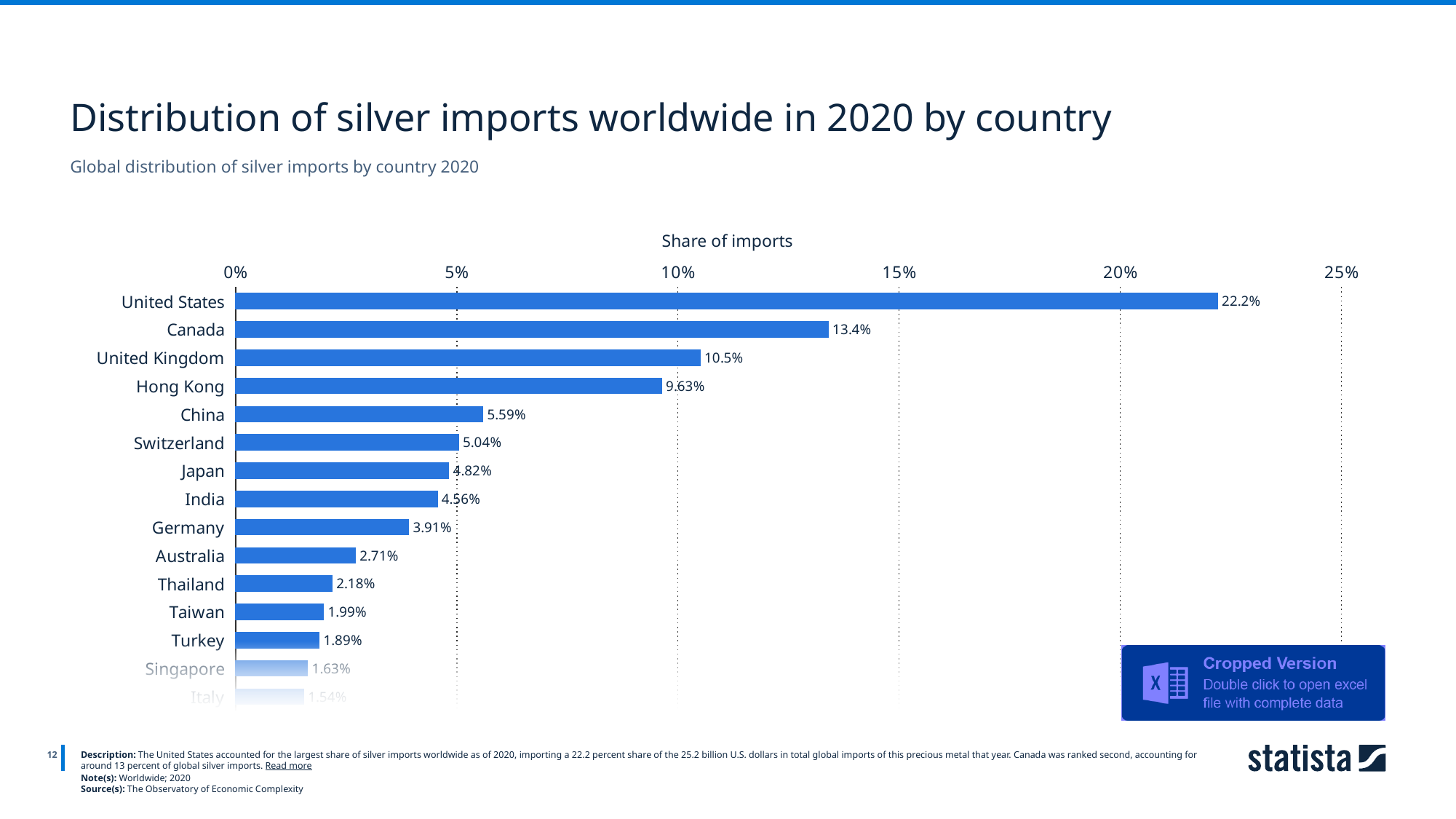
Is the value for the United Kingdom greater or less than 10%? greater What is the difference in percentage points between the United States' share and Canada's share? 8.8 percentage points What kind of chart is shown on the slide? Bar chart What share of silver imports does the United States account for? 22.2% What is the share of imports for Taiwan? 1.99% Which has a larger share of imports, Australia or Thailand? Australia Which has a larger share of imports, Switzerland or Japan? Switzerland Which country has the largest share of silver imports? United States What is the difference in percentage points between Hong Kong's share and China's share? 4.04 percentage points What is the share of imports for Germany? 3.91% What is the share of imports for Hong Kong? 9.63% What is the label on the horizontal axis of the chart? Share of imports